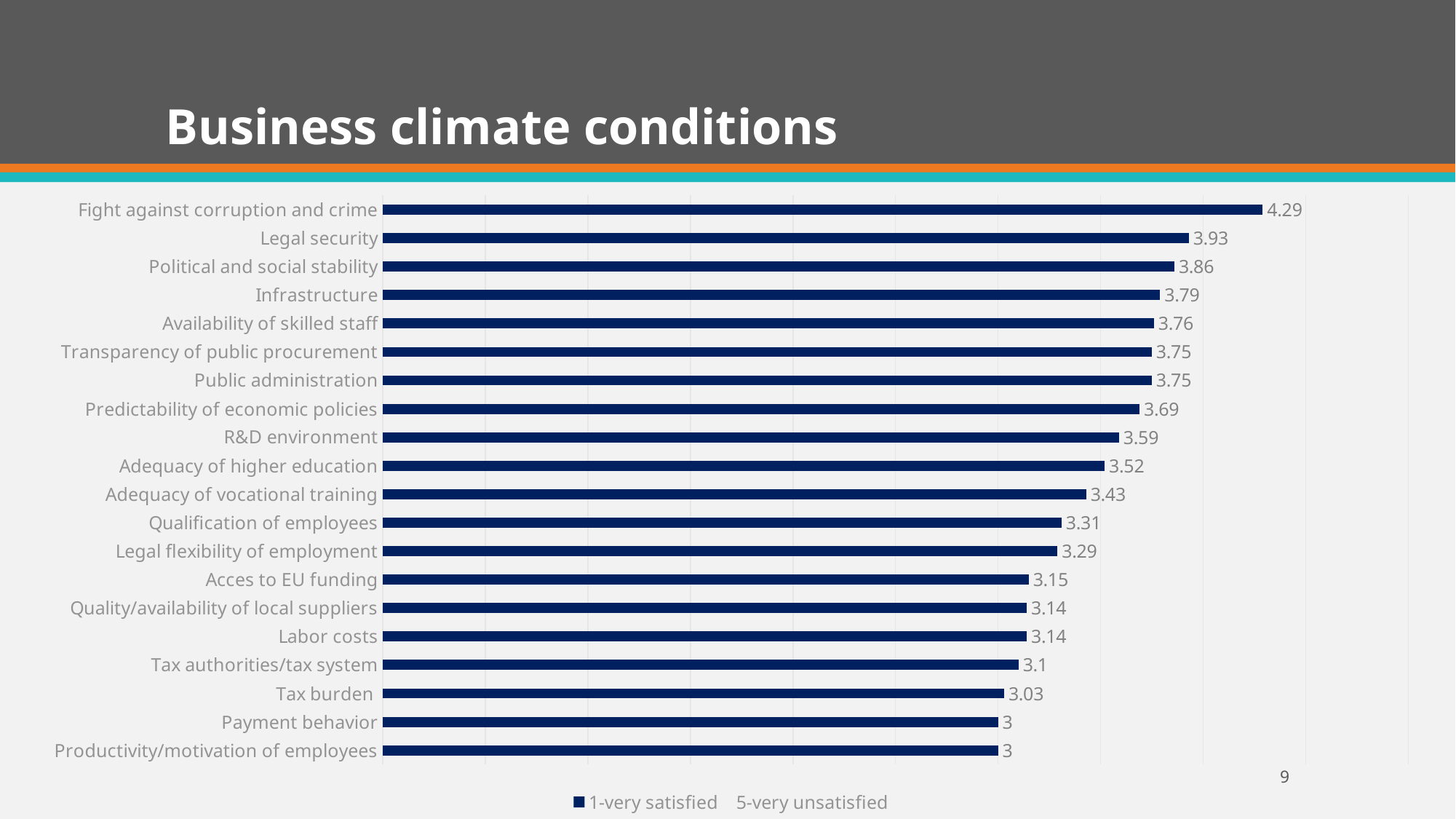
What is the value for Adequacy of vocational training? 3.43 What is the value for Infrastructure? 3.79 Which category has the highest value? Fight against corruption and crime What is the title of the slide? Business climate conditions How many categories are shown in the chart? 20 What is the value for Fight against corruption and crime? 4.29 Which has a larger value, R&D environment or Qualification of employees? R&D environment What is the difference between the values for Fight against corruption and crime and Tax burden? 1.26 What kind of chart is shown on the slide? Bar chart What is the difference between the values for Legal security and Political and social stability? 0.07 Which has a larger value, Acces to EU funding or Legal flexibility of employment? Legal flexibility of employment What is the value for Tax burden? 3.03